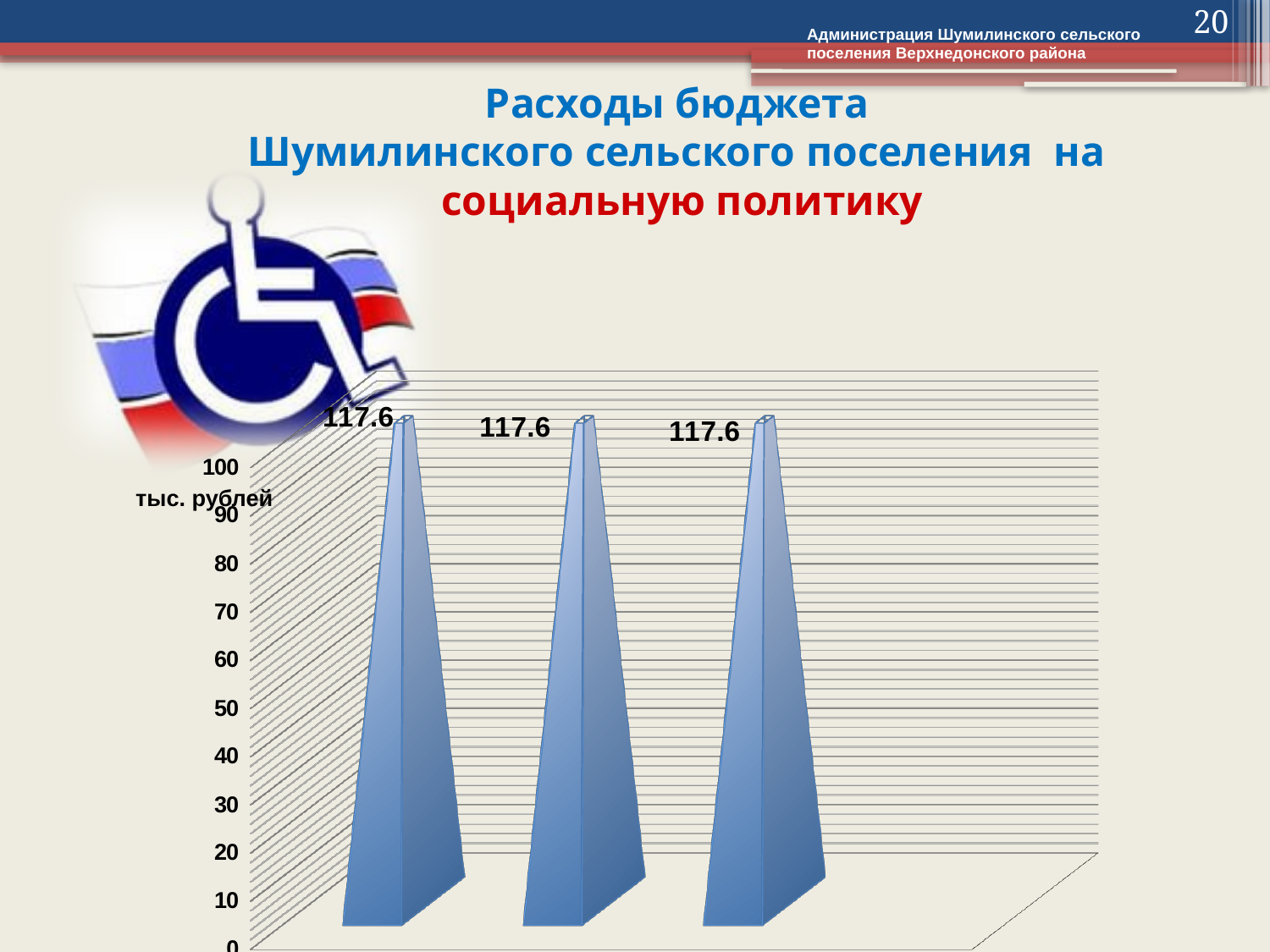
Is the value of the middle bar greater or less than 50? greater What is the difference between the value of the first bar and the value of the third bar? 0 What kind of chart is shown on the slide? bar chart Do the values rise, fall, or stay the same from the first bar to the third bar? stay the same What value is printed on the first (leftmost) bar of the chart? 117.6 Is the value of the first bar greater or less than 100? greater What is the title of the chart on the slide? Расходы бюджета Шумилинского сельского поселения на социальную политику What value is printed on the second (middle) bar of the chart? 117.6 How many bars are plotted in the chart? 3 What value is printed on the third (rightmost) bar of the chart? 117.6 What unit is shown on the vertical axis of the chart? тыс. рублей